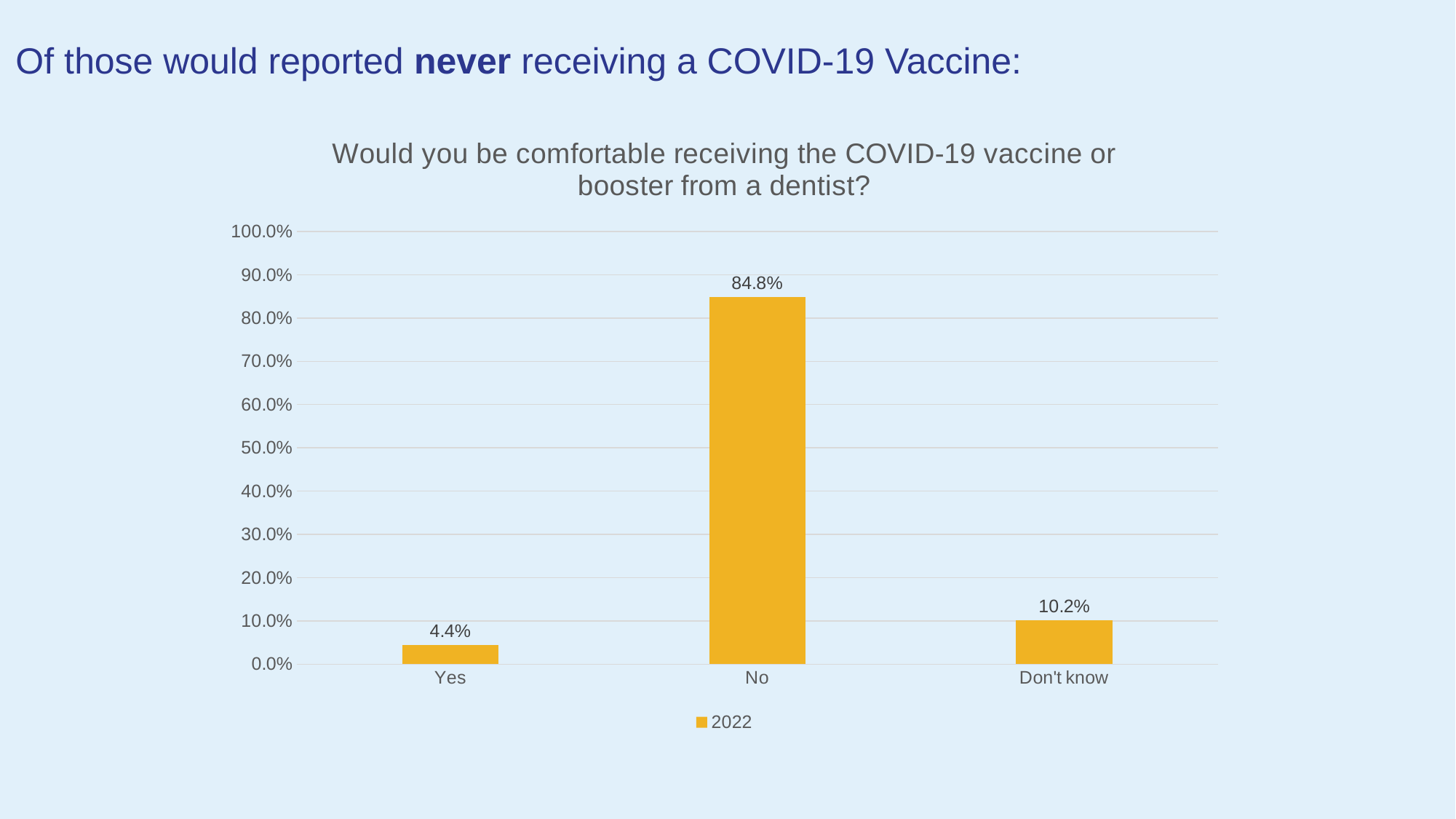
What percentage of respondents answered "No"? 84.8% Which response category has the lowest value? Yes Which is larger, the value for "Don't know" or the value for "Yes"? Don't know How many series does the legend list? 1 What is the difference between the "No" and "Yes" percentages? 80.4% Is the value for "No" greater or less than 80.0%? greater What type of chart is shown on the slide? Bar chart What is the difference between the "Don't know" and "Yes" percentages? 5.8% What percentage of respondents answered "Don't know"? 10.2% How many response categories are shown on the x axis? 3 What percentage of respondents answered "Yes"? 4.4% Which response category has the highest value? No